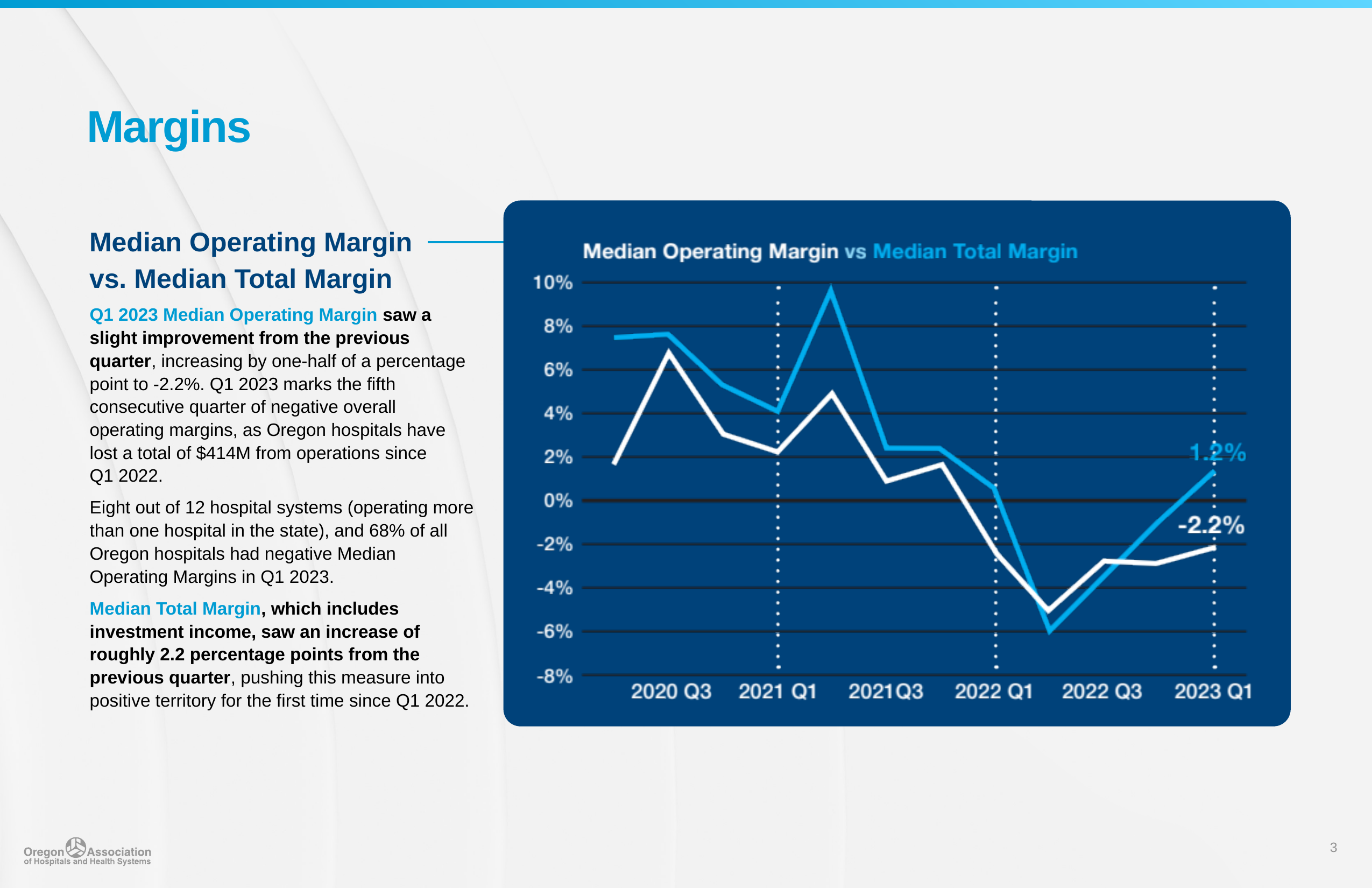
What colour is the Median Total Margin line in the chart? Light blue Is the Median Operating Margin at 2020 Q3 greater or less than 4%? greater In 2023 Q1, which is higher: Median Operating Margin or Median Total Margin? Median Total Margin Is the Median Total Margin at 2022 Q1 greater or less than 2%? less What kind of chart is shown on the slide? Line chart Does the Median Total Margin rise or fall from 2022 Q3 to 2023 Q1? Rise What is the Median Operating Margin value labelled for 2023 Q1? -2.2% Is the Median Total Margin at 2021 Q1 greater or less than 6%? less In 2023 Q1, what is the difference between the Median Total Margin and the Median Operating Margin? 3.4 percentage points How many series are plotted in the chart? 2 What is the Median Total Margin value labelled for 2023 Q1? 1.2%